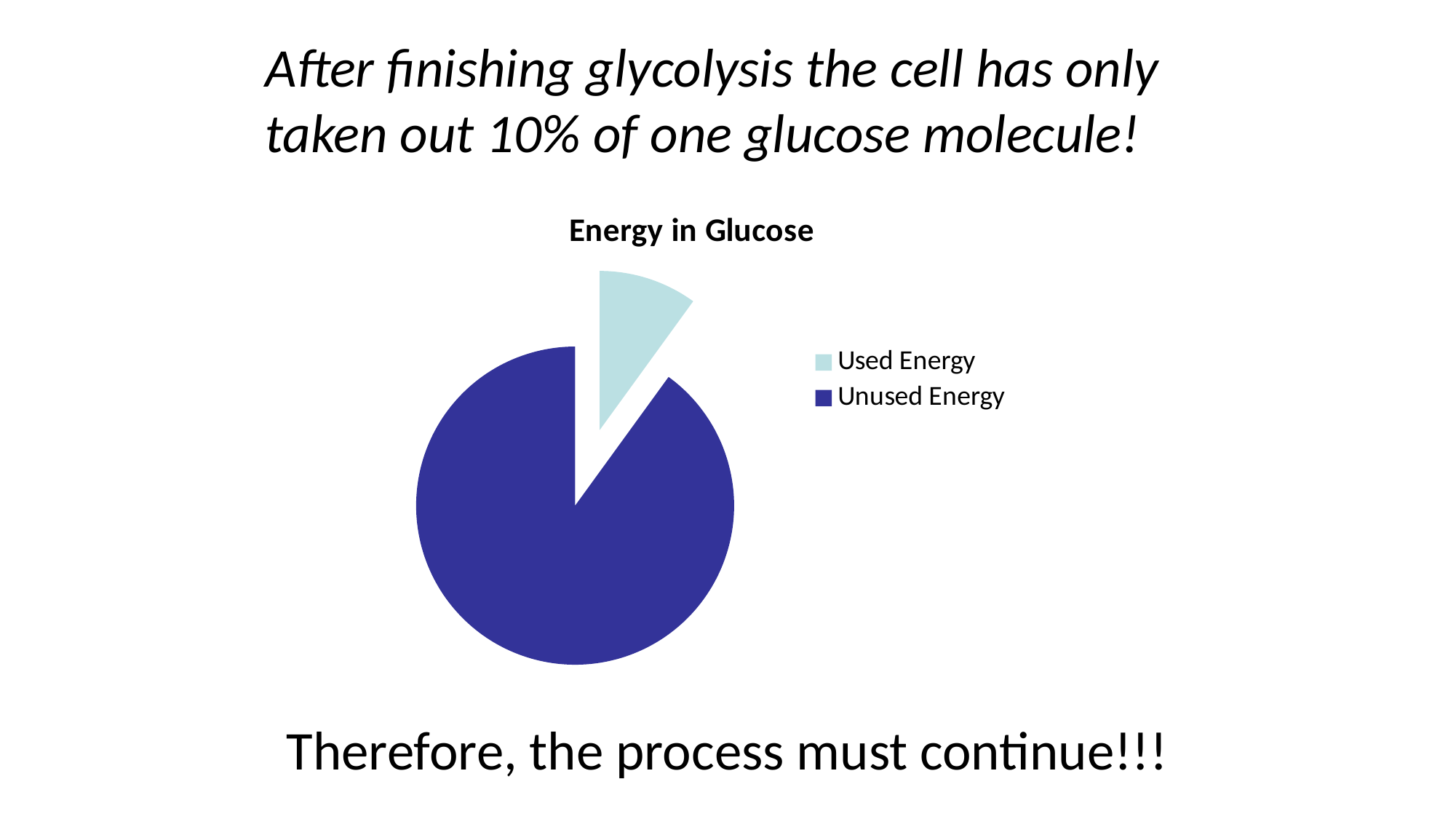
How many entries does the chart legend list? 2 Which slice of the pie chart is pulled out (exploded) from the rest? Used Energy Which legend entry is shown in light blue? Used Energy Which slice of the pie chart is the largest? Unused Energy What is the title of the chart? Energy in Glucose How many slices does the pie chart have? 2 Which slice of the pie chart is the smallest? Used Energy Which is larger in the pie chart, Used Energy or Unused Energy? Unused Energy What kind of chart is shown on the slide? pie chart